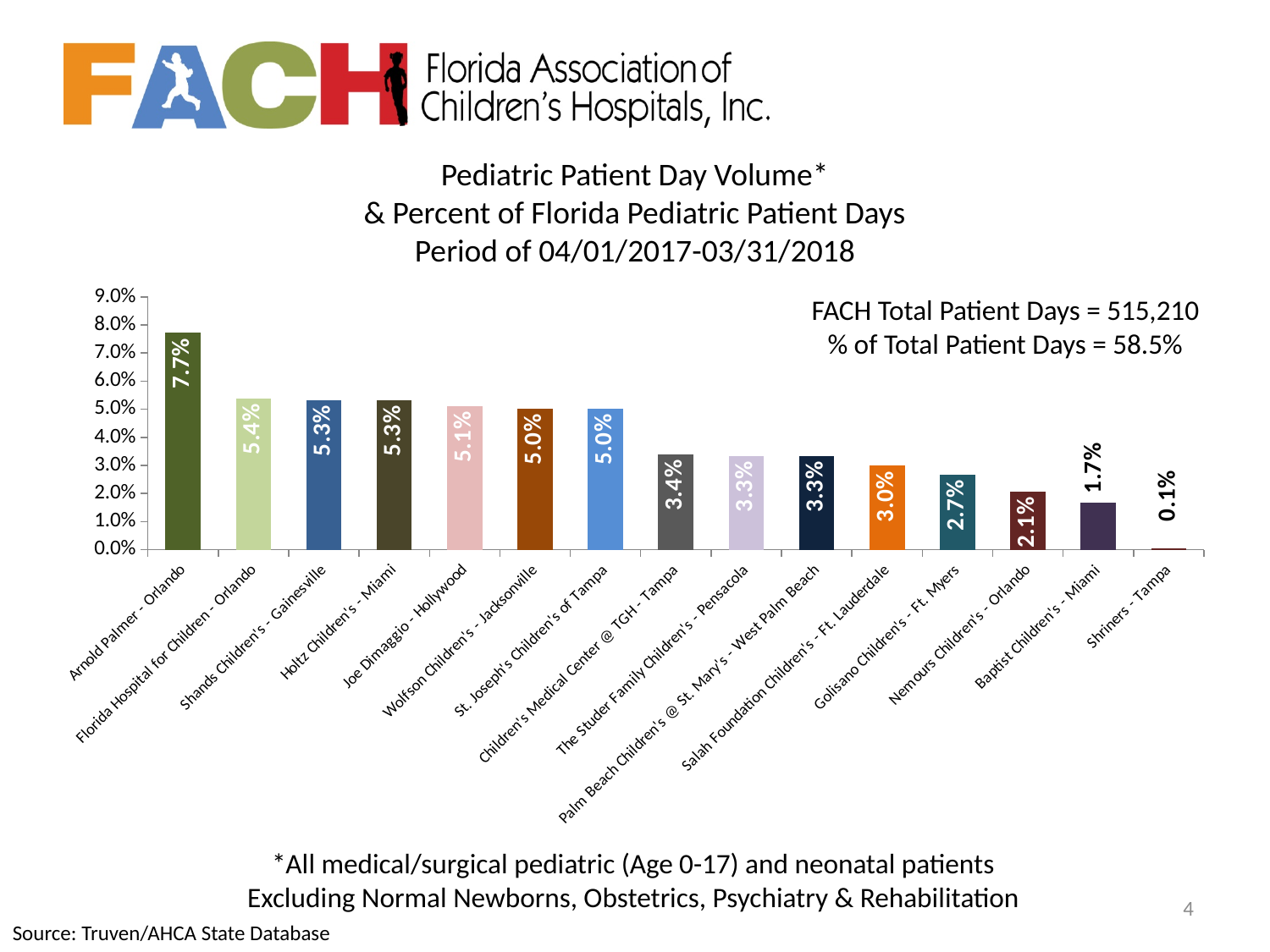
What kind of chart is shown on the slide? bar chart Which hospital has the highest percentage of Florida pediatric patient days? Arnold Palmer - Orlando What percentage of Florida pediatric patient days is shown for Arnold Palmer - Orlando? 7.7% Which is larger, the value for Joe Dimaggio - Hollywood or the value for Children's Medical Center @ TGH - Tampa? Joe Dimaggio - Hollywood What value is shown for Nemours Children's - Orlando? 2.1% Do the values generally rise or fall from left to right across the chart? fall How many hospitals are shown on the chart? 15 What is the difference between the values for Arnold Palmer - Orlando and Florida Hospital for Children - Orlando? 2.3% Is the value for Salah Foundation Children's - Ft. Lauderdale greater or less than 4.0%? less Which hospital has the lowest percentage of Florida pediatric patient days? Shriners - Tampa What is the difference between the values for Baptist Children's - Miami and Shriners - Tampa? 1.6% What value is shown for Golisano Children's - Ft. Myers? 2.7%